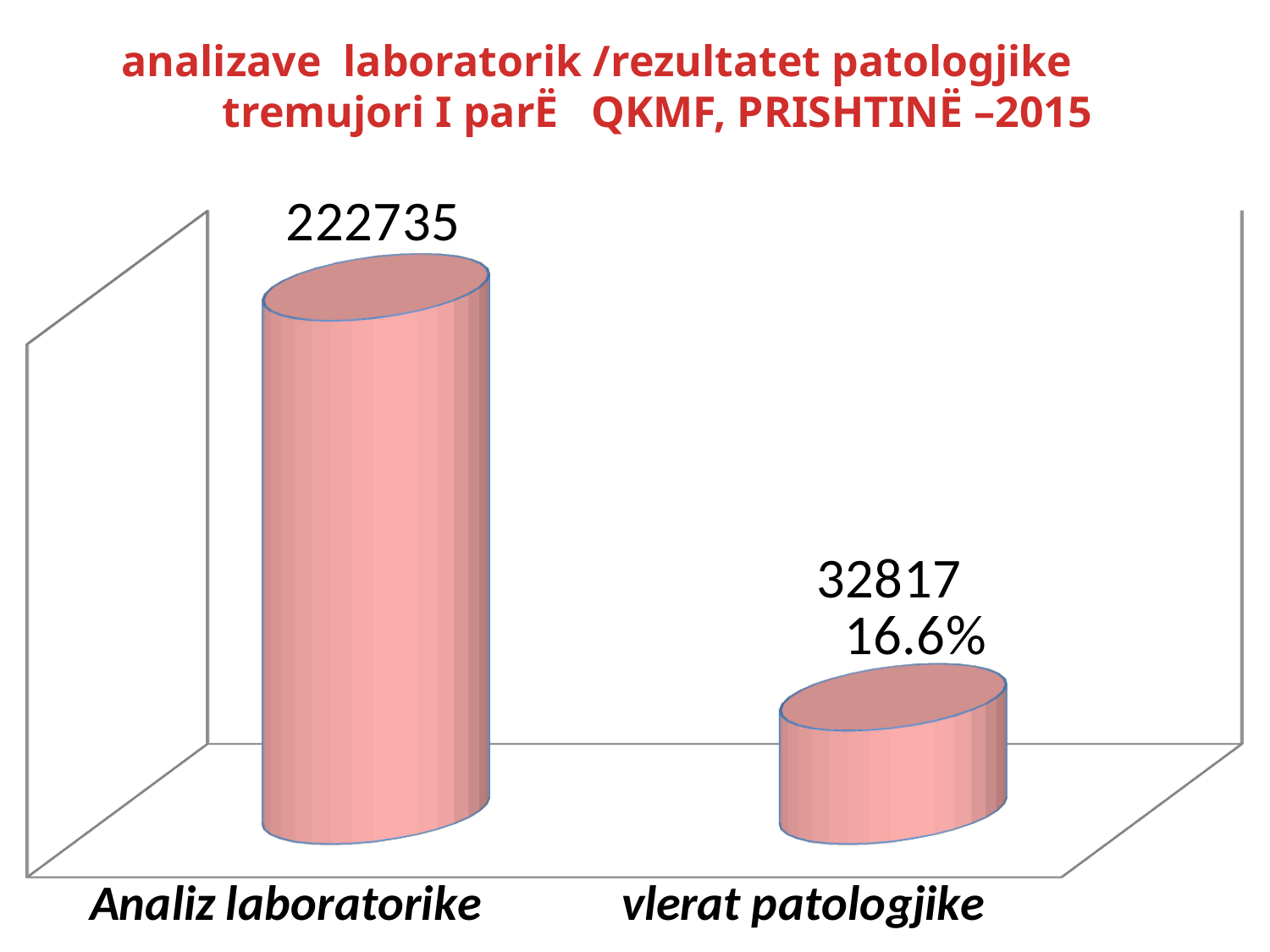
Which category has the lowest value? vlerat patologjike What is the value for vlerat patologjike? 32817 What is the value for Analiz laboratorike? 222735 Do the values rise or fall from left to right across the categories? fall What is the total of the two values shown in the chart? 255552 How many categories are shown in the chart? 2 What percentage is shown above the vlerat patologjike bar? 16.6% What is the difference between the values for Analiz laboratorike and vlerat patologjike? 189918 What year is mentioned in the chart title? 2015 Which category has the highest value? Analiz laboratorike Which is larger, the value for Analiz laboratorike or the value for vlerat patologjike? Analiz laboratorike What kind of chart is shown on the slide? bar chart